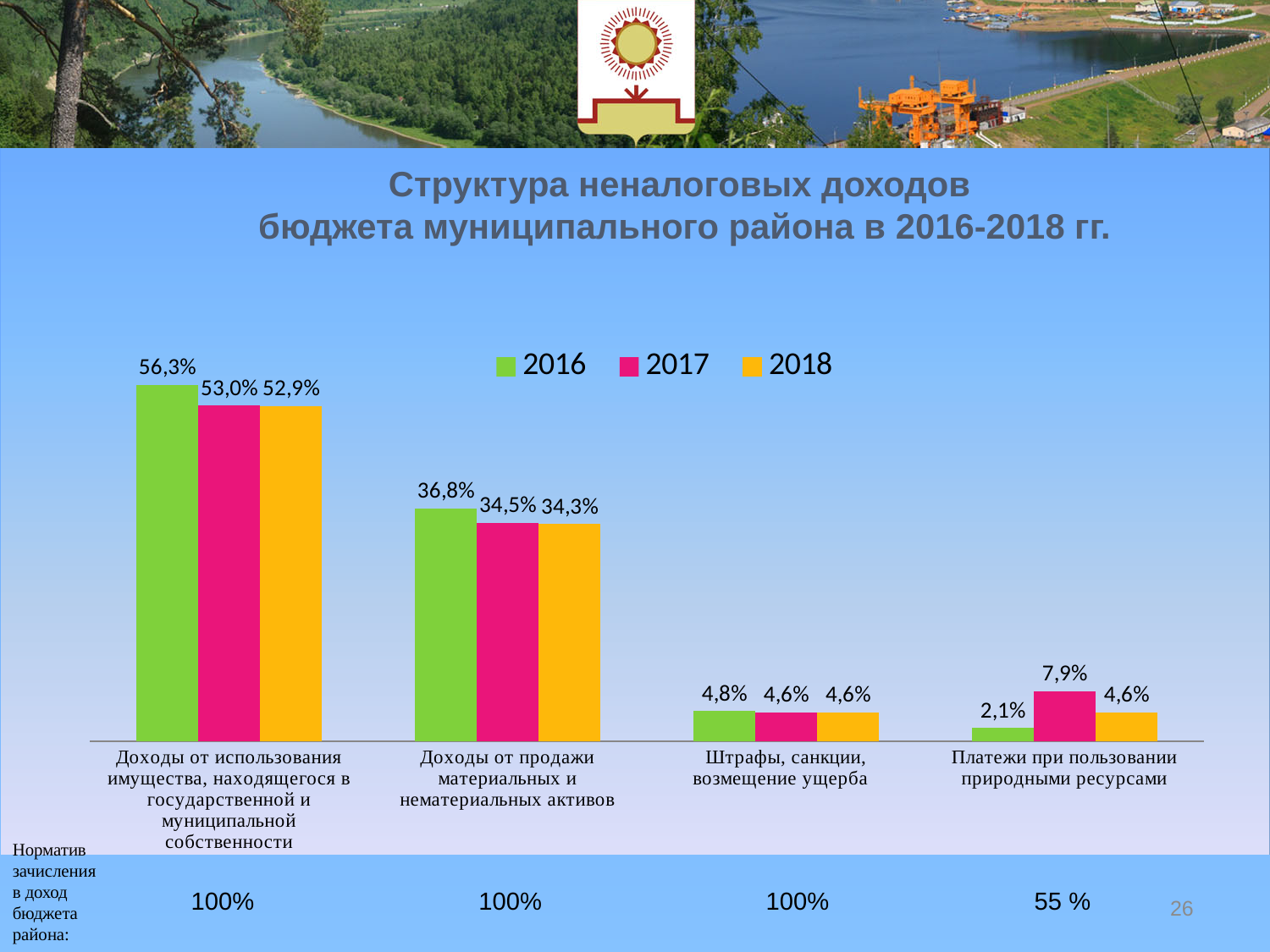
Which year is shown in yellow in the legend? 2018 What is the 2016 value for «Доходы от использования имущества, находящегося в государственной и муниципальной собственности»? 56,3% How many series does the legend list? 3 What type of chart is shown on the slide? bar chart What is the difference between the 2016 and 2018 values for «Доходы от использования имущества, находящегося в государственной и муниципальной собственности»? 3,4% What is the 2018 value for «Доходы от продажи материальных и нематериальных активов»? 34,3% Which category has the lowest value in 2016? Платежи при пользовании природными ресурсами Which category has the highest value in 2017? Доходы от использования имущества, находящегося в государственной и муниципальной собственности What is the 2016 value for «Штрафы, санкции, возмещение ущерба»? 4,8% How many categories are shown on the x axis? 4 For «Платежи при пользовании природными ресурсами», which is larger: the 2017 value or the 2018 value? 2017 What is the 2017 value for «Платежи при пользовании природными ресурсами»? 7,9%